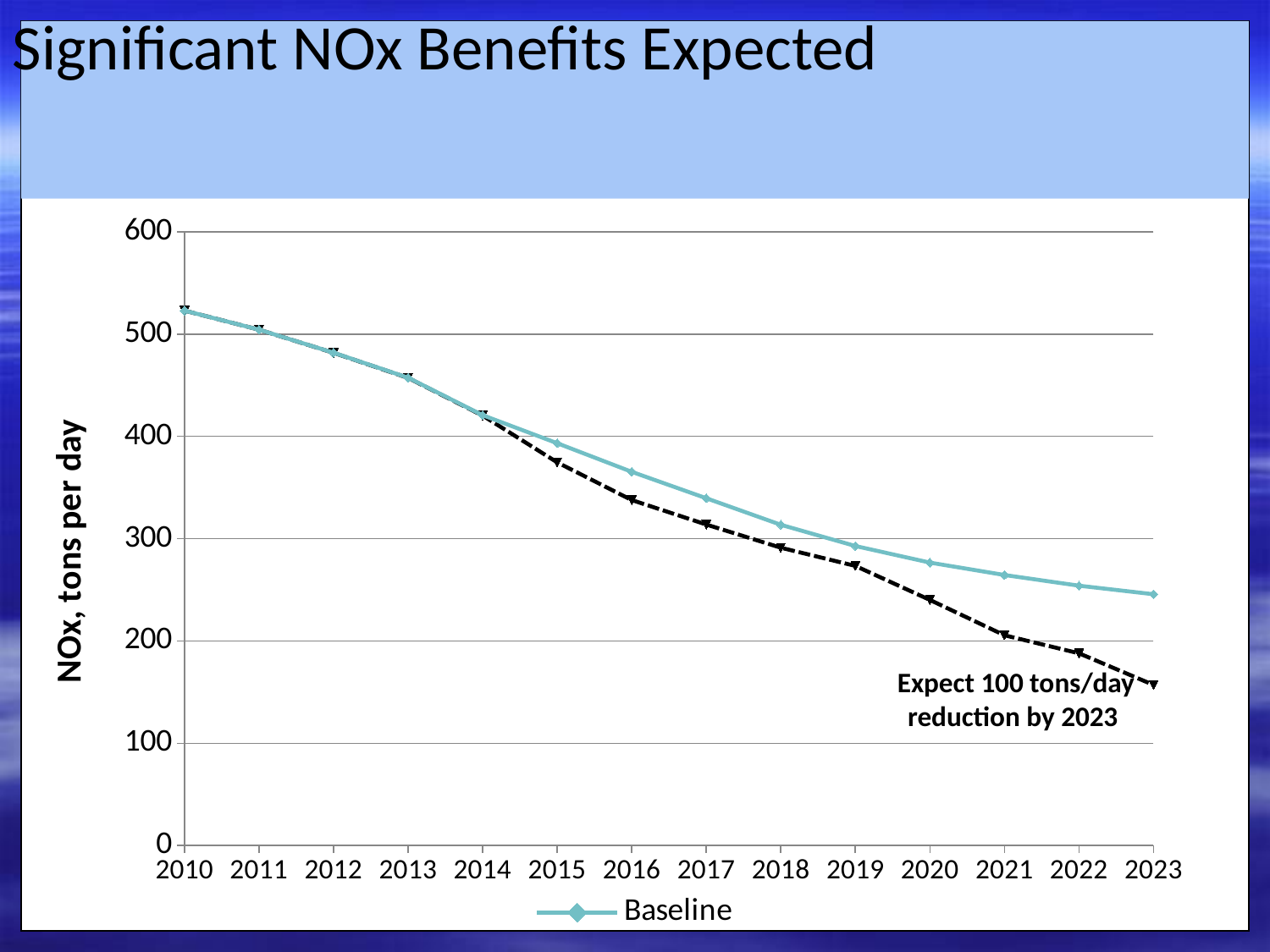
What kind of chart is shown on the slide? line chart Is the value of the dashed line for 2023 greater or less than 200? less In which year is the Baseline value highest? 2010 Is the Baseline value for 2016 greater or less than 300? greater How many series does the legend list? 1 Is the Baseline value for 2010 greater or less than 500? greater In 2023, which is higher: the Baseline line or the dashed line? Baseline Does the Baseline series rise or fall from 2010 to 2023? fall How many years are plotted along the x axis? 14 What is the title of the y axis? NOx, tons per day In which year is the Baseline value lowest? 2023